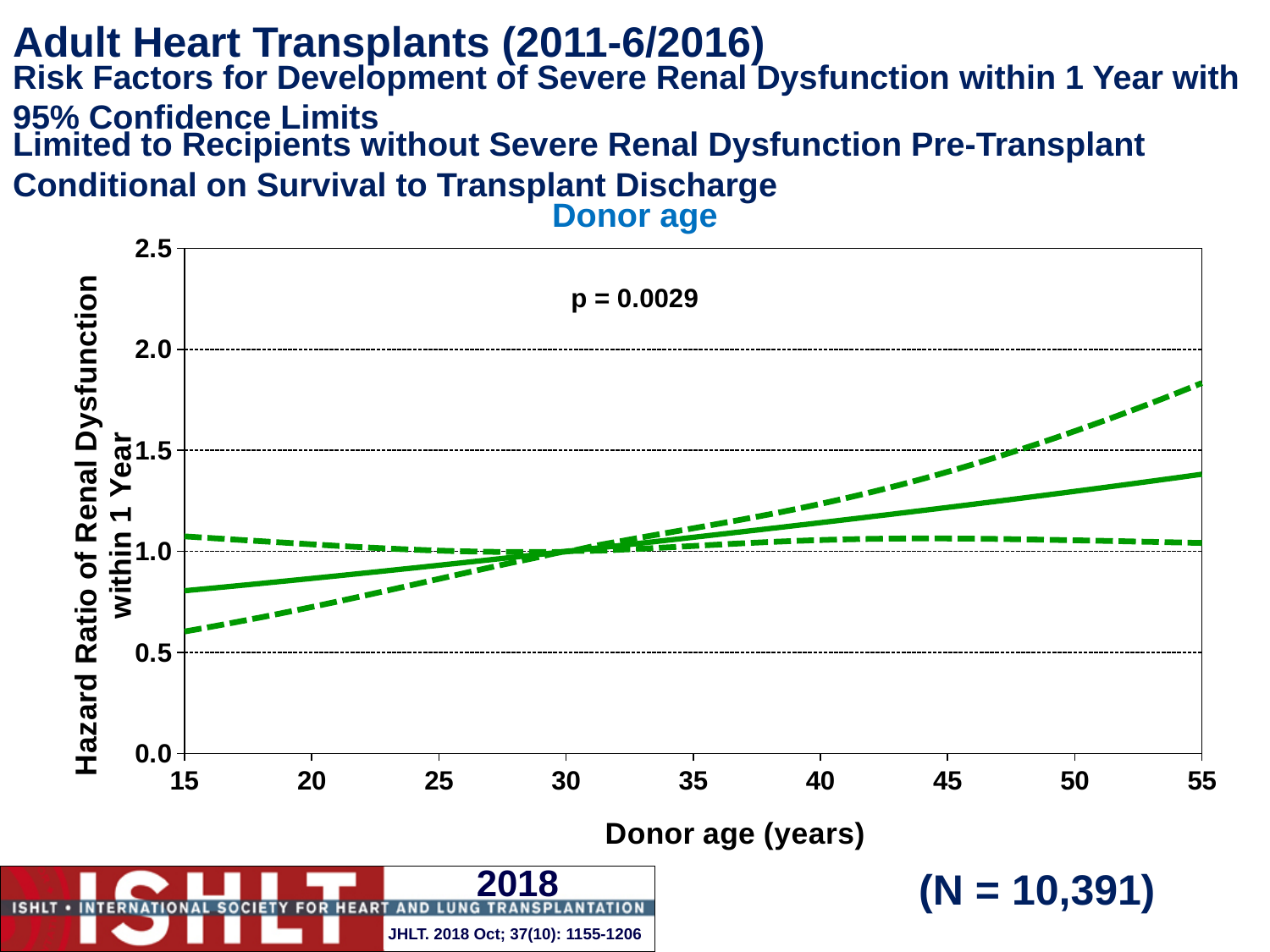
What is the title of the chart? Donor age Does the solid hazard ratio line rise or fall as donor age increases from 15 to 55 years? rise Is the solid hazard ratio line at donor age 55 greater or less than 1.0? greater Is the solid hazard ratio line at donor age 15 greater or less than 1.0? less Is the solid hazard ratio line at donor age 55 greater or less than 1.5? less What p-value is printed on the chart? p = 0.0029 How many lines are plotted on the chart? 3 What is the label of the x axis? Donor age (years) What sample size (N) is printed on the slide? N = 10,391 What kind of chart is shown on the slide? line chart